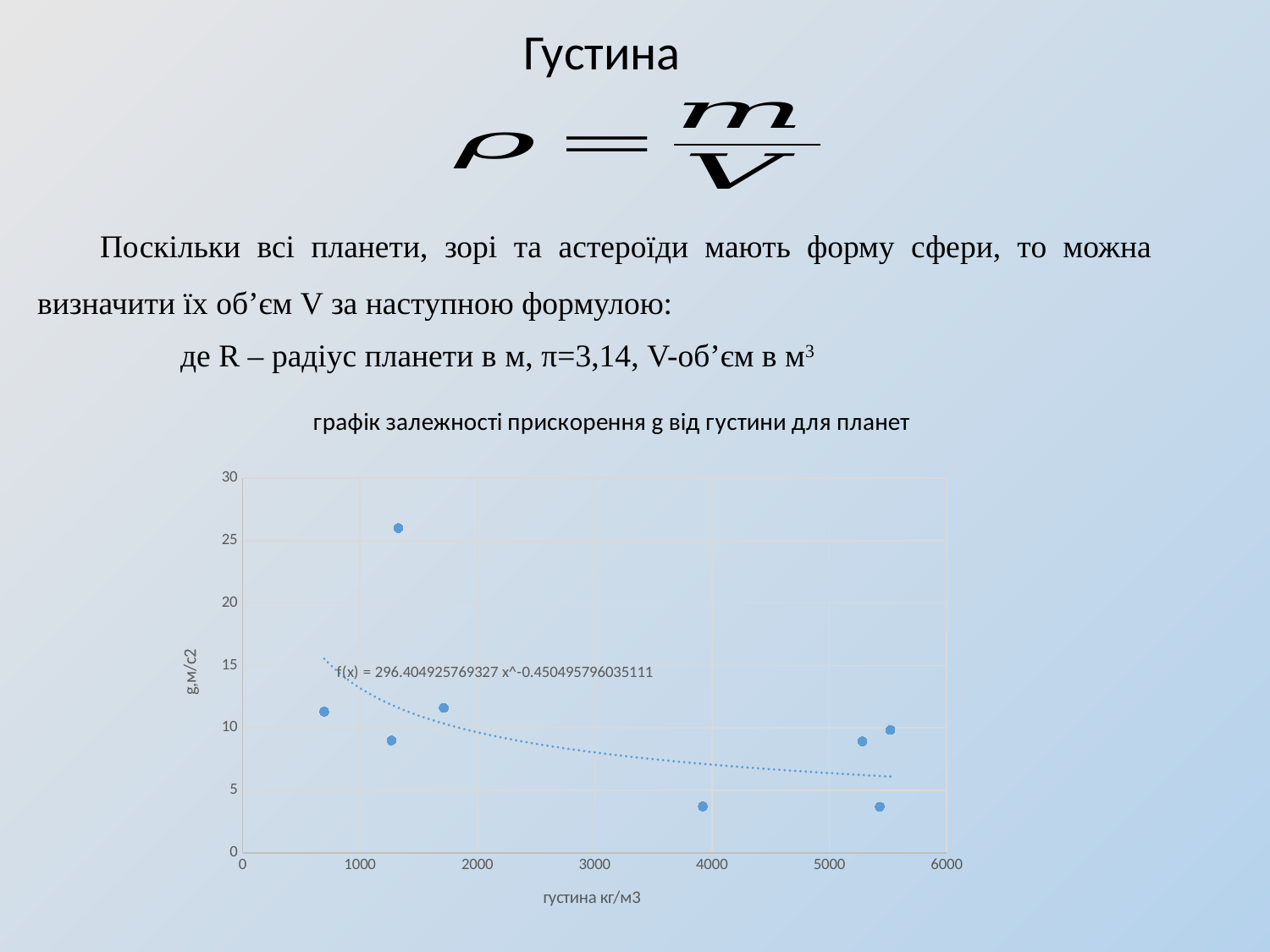
What kind of chart is shown on the slide? scatter chart Is the g value of the point plotted near a density of 4000 кг/м3 greater or less than 5? less What is the title of the chart? графік залежності прискорення g від густини для планет Is the g value of the point plotted near a density of 700 кг/м3 greater or less than 10? greater Is the density of the highest point on the chart greater or less than 2000 кг/м3? less Which has the larger g value: the point near a density of 1300 кг/м3 at the top of the chart or the point near a density of 5500 кг/м3? the point near 1300 кг/м3 What is the label of the horizontal axis of the chart? густина кг/м3 How many data points are plotted on the chart? 8 Does the dotted trendline on the chart rise or fall as density increases along the x axis? fall